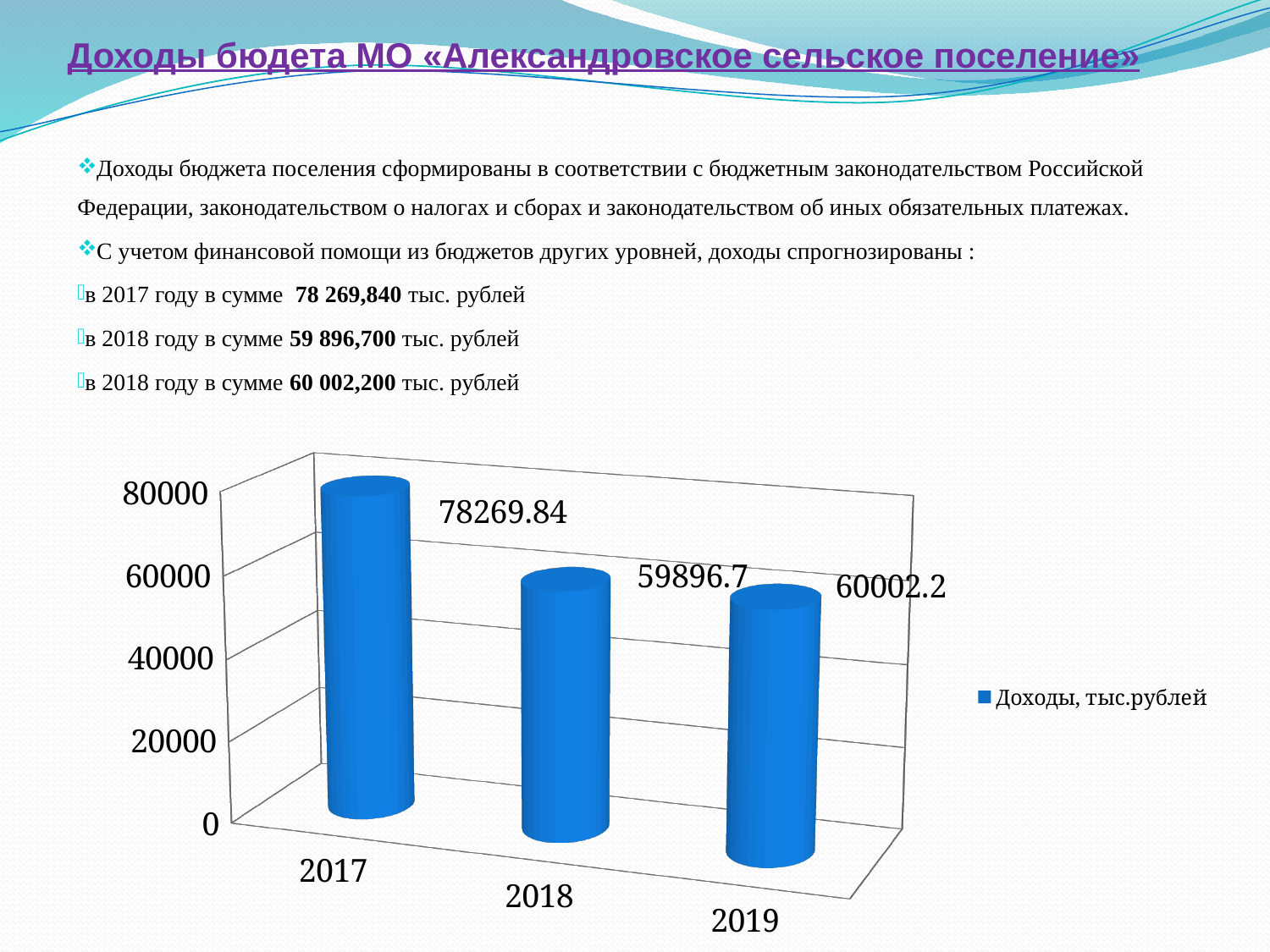
Which is larger, the value for 2017 or the value for 2018? 2017 How many years are shown on the x axis of the chart? 3 What is the difference between the values for 2017 and 2018? 18373.14 Which year has the highest value in the chart? 2017 Is the value for 2017 greater or less than 60000? greater What is the value for 2018 in the chart? 59896.7 What is the value for 2017 in the chart? 78269.84 Is the value for 2019 greater or less than 80000? less What is the value for 2019 in the chart? 60002.2 What kind of chart is shown on the slide? bar chart What is the difference between the values for 2017 and 2019? 18267.64 How many series does the chart legend list? 1